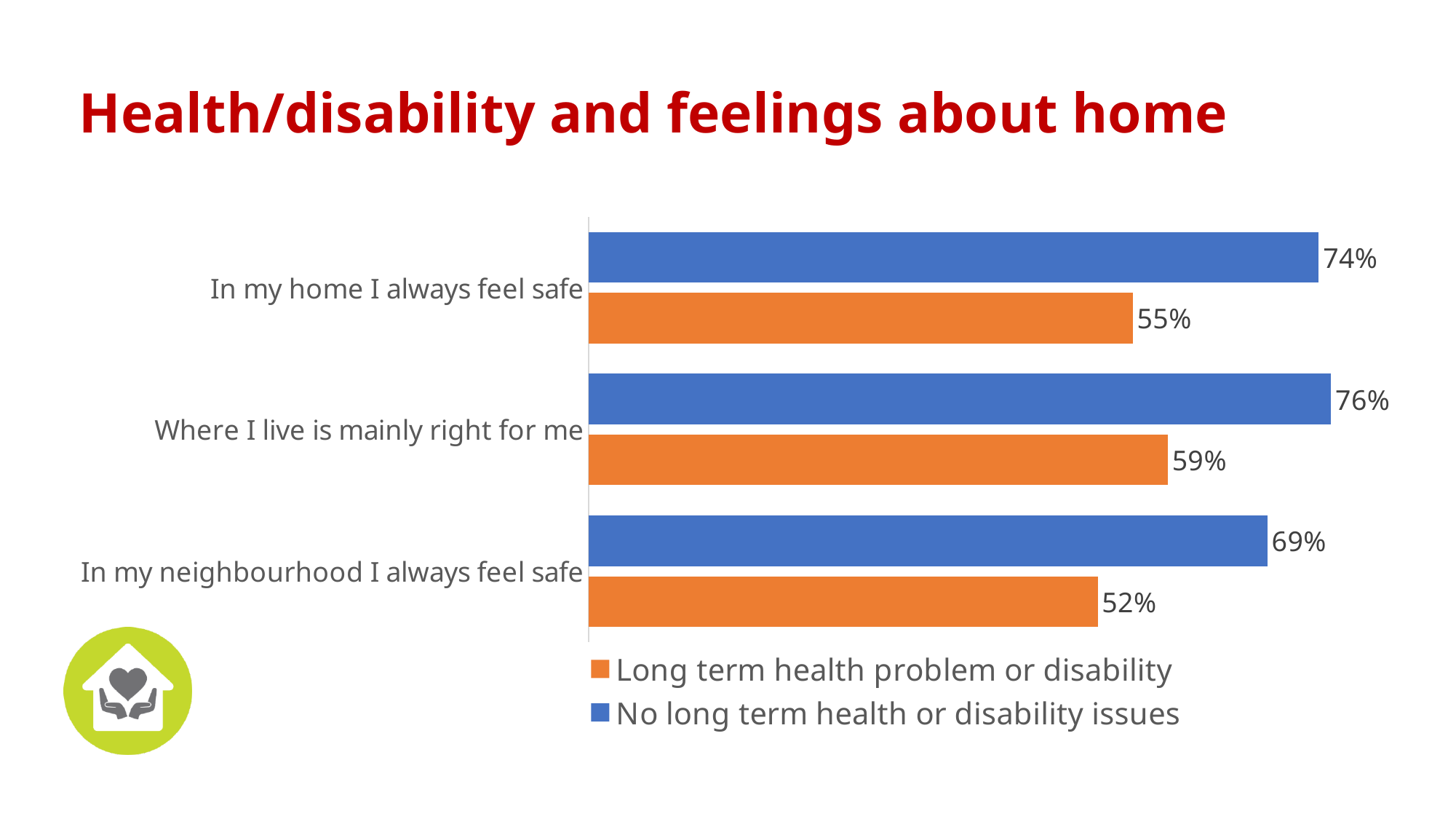
What kind of chart is shown on the slide? Bar chart For 'In my neighbourhood I always feel safe', which group has the larger value? No long term health or disability issues What is the difference between the two groups for 'Where I live is mainly right for me'? 17 percentage points How many series does the legend list? 2 What percentage of people with a long term health problem or disability say 'Where I live is mainly right for me'? 59% Which statement has the lowest value for the 'Long term health problem or disability' group? In my neighbourhood I always feel safe What is the difference between the two groups for 'In my home I always feel safe'? 19 percentage points Which colour represents the 'Long term health problem or disability' group? Orange What percentage of people with no long term health or disability issues say 'In my home I always feel safe'? 74% What percentage of people with a long term health problem or disability say 'In my neighbourhood I always feel safe'? 52% Which statement has the highest value for the 'No long term health or disability issues' group? Where I live is mainly right for me How many statements (categories) are shown on the chart? 3